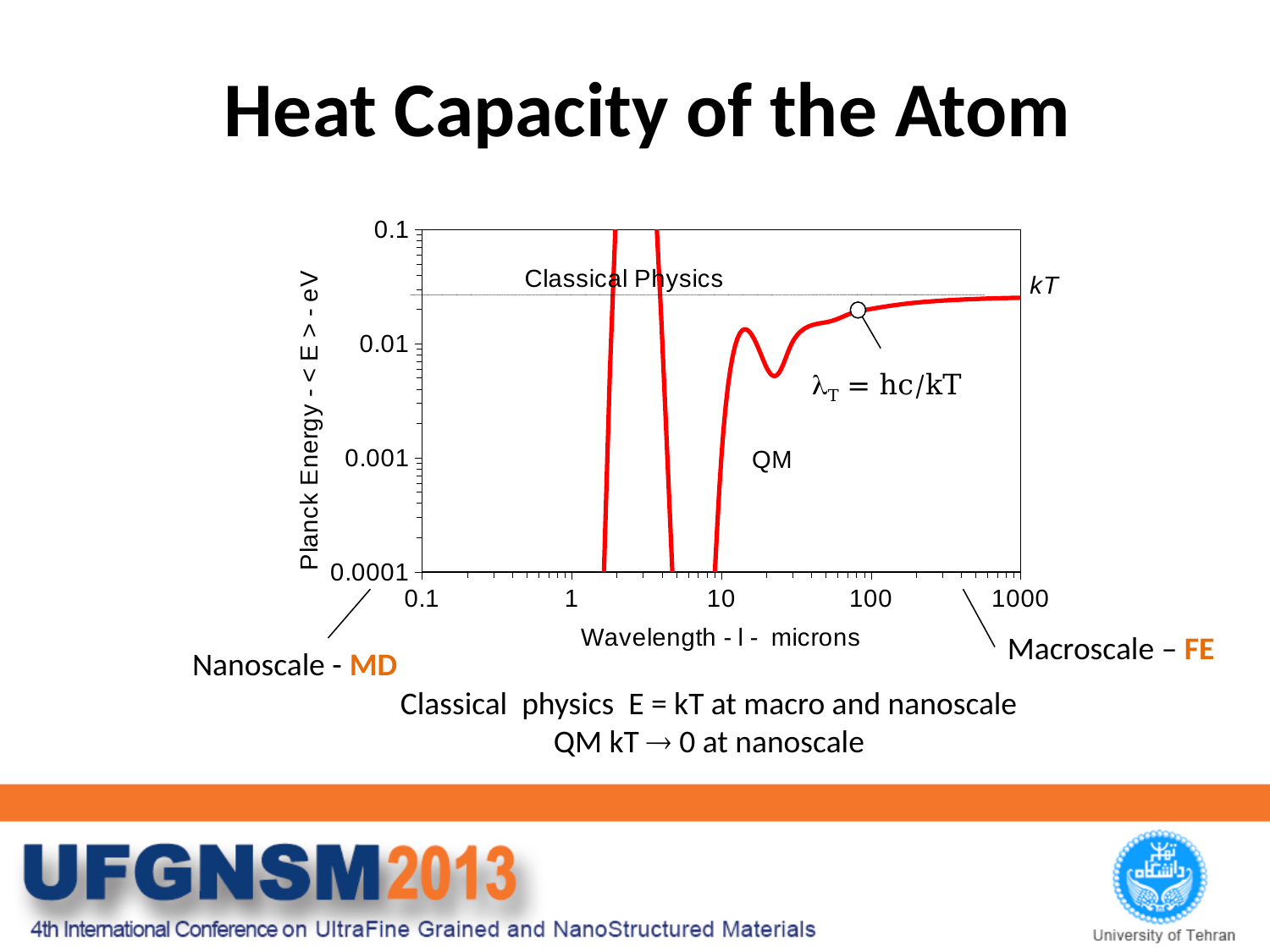
How many labelled tick values are shown on the x axis of the chart? 5 Is the value of the red curve at a wavelength of 100 microns greater or less than 0.01? greater Is the value of the red curve at a wavelength of 1000 microns greater or less than 0.01? greater What is the title of the y axis of the chart? Planck Energy - < E > - eV Does the red curve rise or fall as the wavelength increases from 100 to 1000 microns? rises What is the title of the x axis of the chart? Wavelength - l - microns What kind of chart is shown on the slide? line chart Which is larger, the value of the red curve at 1000 microns or its value at 10 microns? 1000 microns What is the lowest value labelled on the y axis of the chart? 0.0001 What is the highest value labelled on the y axis of the chart? 0.1 What is the largest wavelength value labelled on the x axis of the chart? 1000 Is the value of the red curve at a wavelength of 1000 microns greater or less than 0.1? less